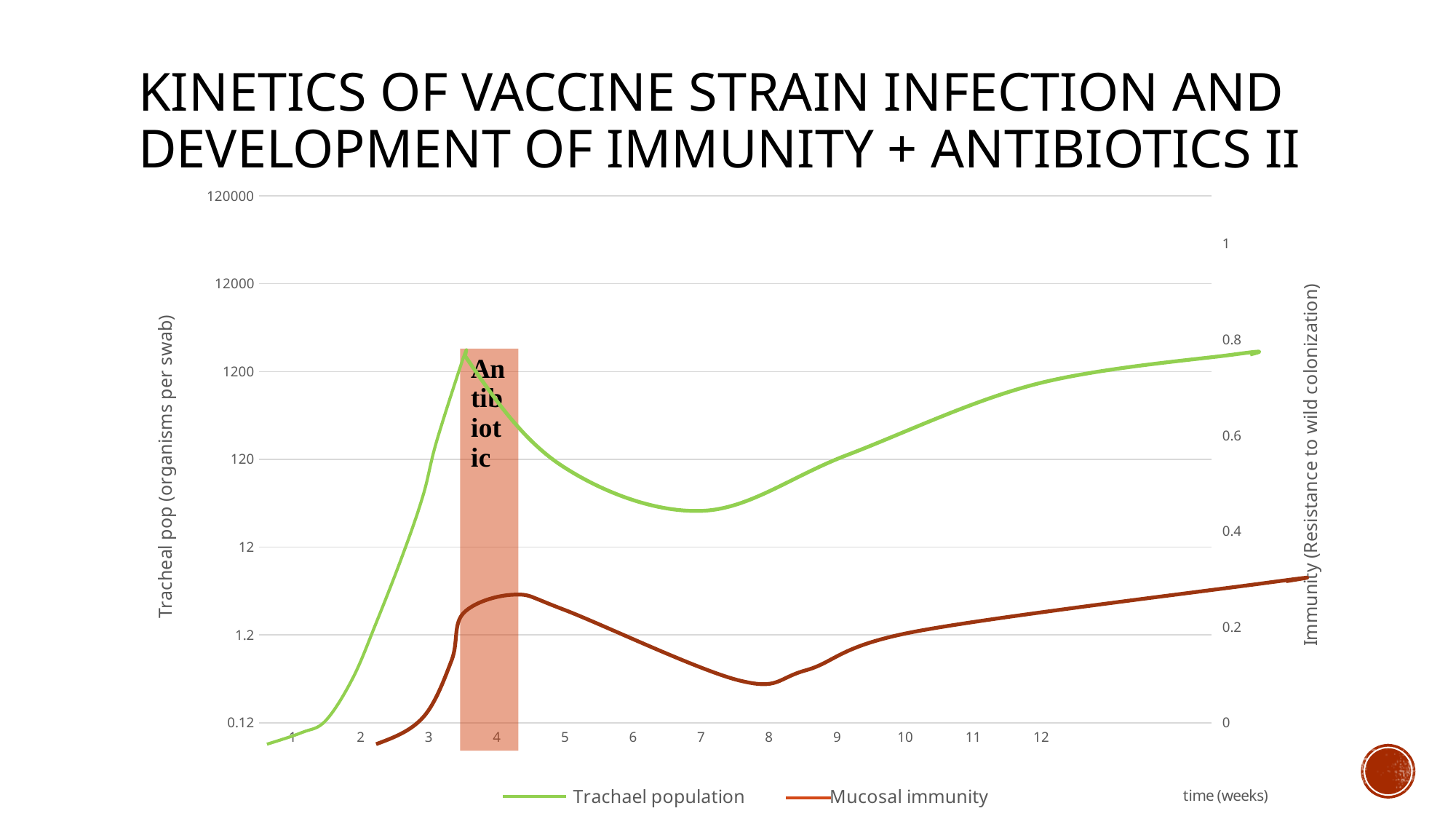
Does the Trachael population line rise or fall between week 4 and week 7? Fall What are the two series named in the legend? Trachael population and Mucosal immunity How many series does the legend list? 2 Is the Mucosal immunity value at week 12 greater or less than 0.2? greater Is the Mucosal immunity value at week 8 greater or less than 0.2? less Is the Trachael population value at week 7 greater or less than 120? less How many week labels are shown on the x axis? 12 Does the Trachael population line rise or fall between week 1 and week 3? Rise Does the Mucosal immunity line rise or fall between week 8 and week 12? Rise What kind of chart is shown on the slide? Line chart What is the label of the left vertical axis? Tracheal pop (organisms per swab)